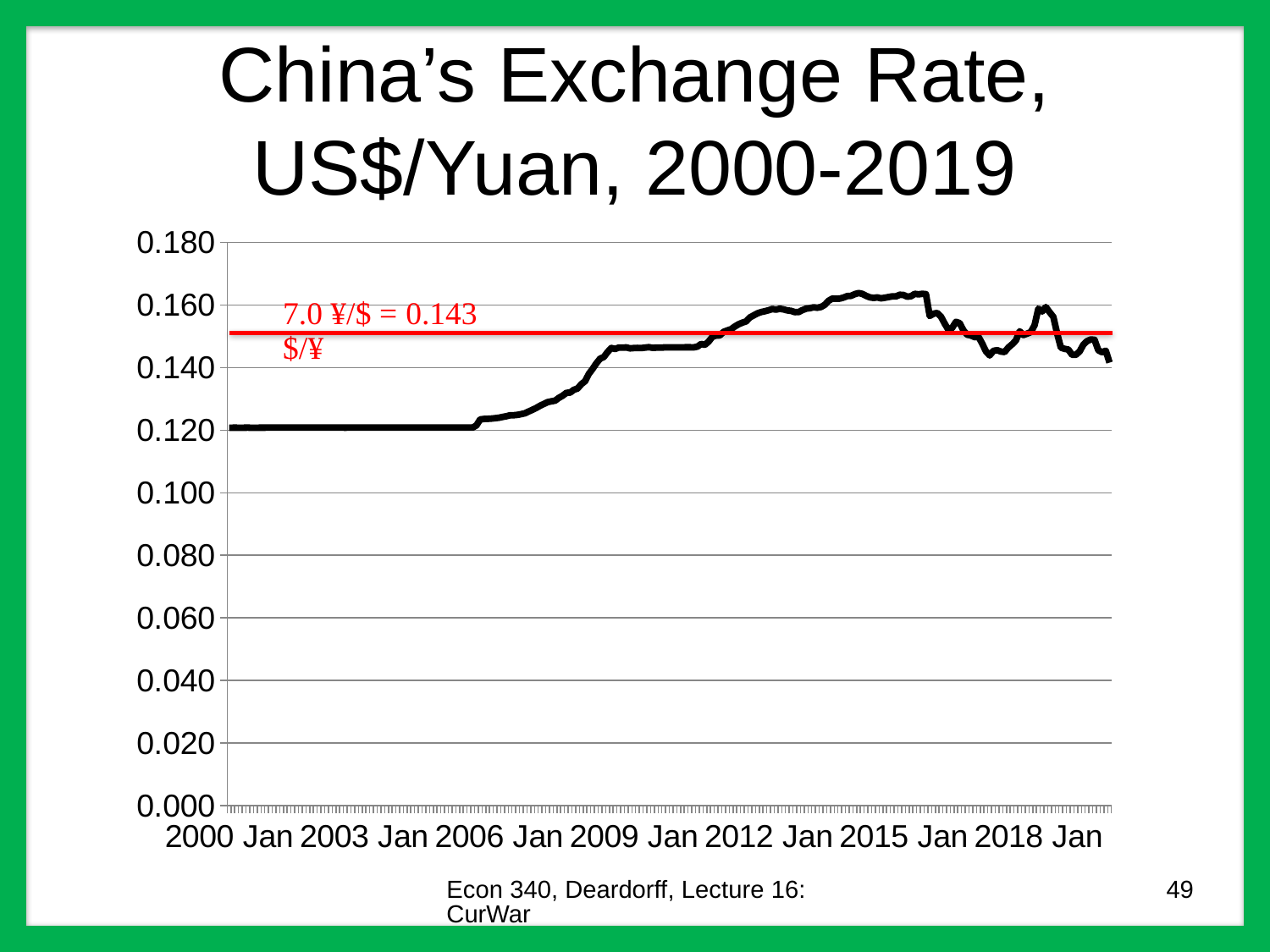
Does the exchange rate rise or fall between 2006 Jan and 2009 Jan? rise What value does the red annotation say 7.0 ¥/$ equals? 0.143 $/¥ Is the exchange rate at 2012 Jan greater or less than 0.140? greater What is the title of the chart? China's Exchange Rate, US$/Yuan, 2000-2019 How many labelled tick marks are on the x axis? 7 What is the highest value labelled on the y axis? 0.180 Is the exchange rate at 2003 Jan greater or less than 0.140? less Is the exchange rate at 2015 Jan greater or less than 0.140? greater What kind of chart is shown on the slide? line chart Is the exchange rate higher at 2015 Jan or at 2003 Jan? 2015 Jan